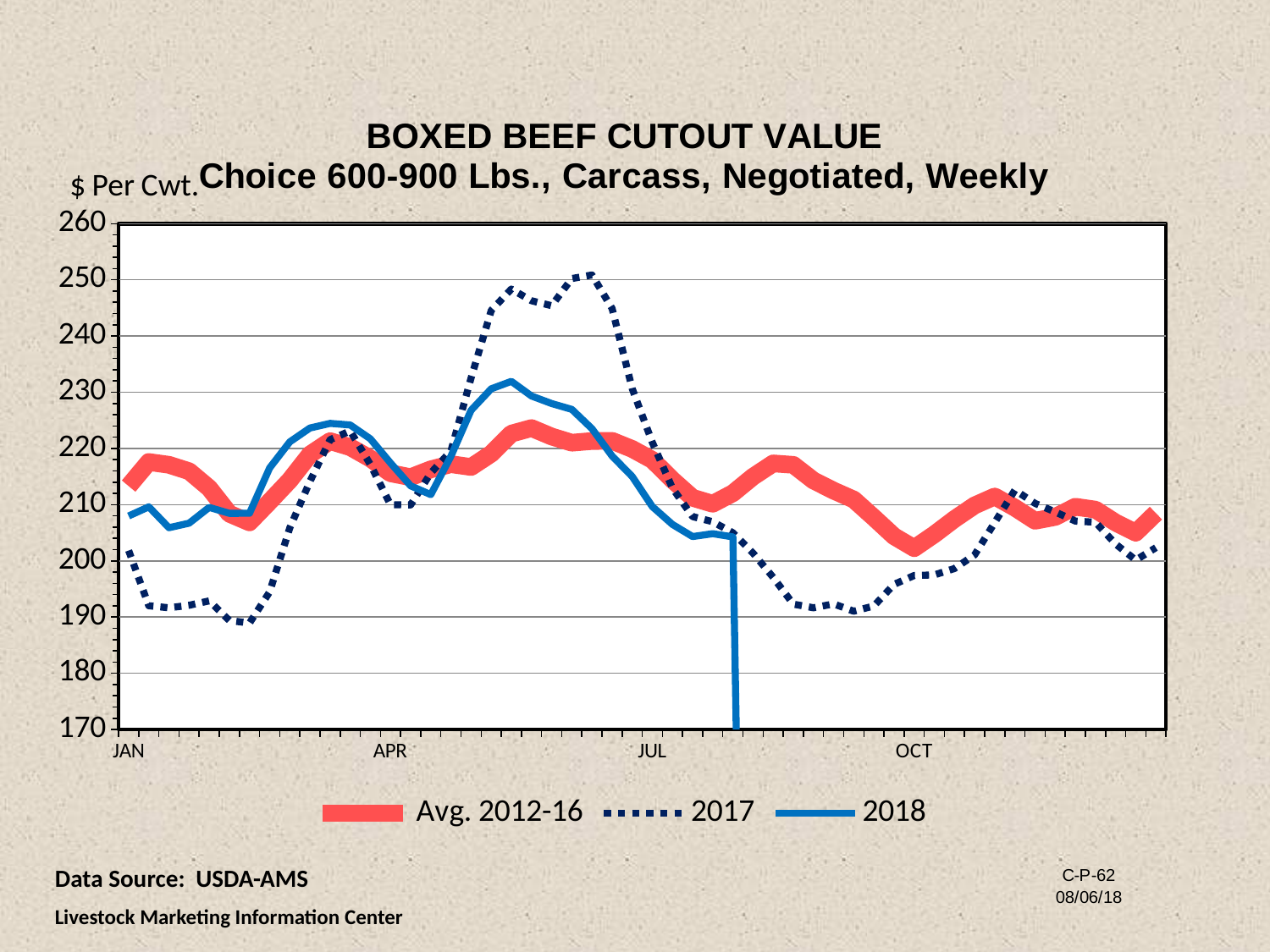
What is the unit shown on the y axis of the chart? $ Per Cwt. Does the 2017 line rise or fall between JUL and OCT? fall How many series does the legend list? 3 Which series is drawn as a dotted line in the chart? 2017 How many month labels are shown on the x axis? 4 Is the 2017 value at OCT greater or less than 200? less Is the Avg. 2012-16 value at JAN greater or less than 210? greater At JUL, which series has the higher value, 2017 or 2018? 2017 Is the peak value of the 2018 line greater or less than 240? less What kind of chart is shown on the slide? line chart At JAN, which series has the higher value, Avg. 2012-16 or 2017? Avg. 2012-16